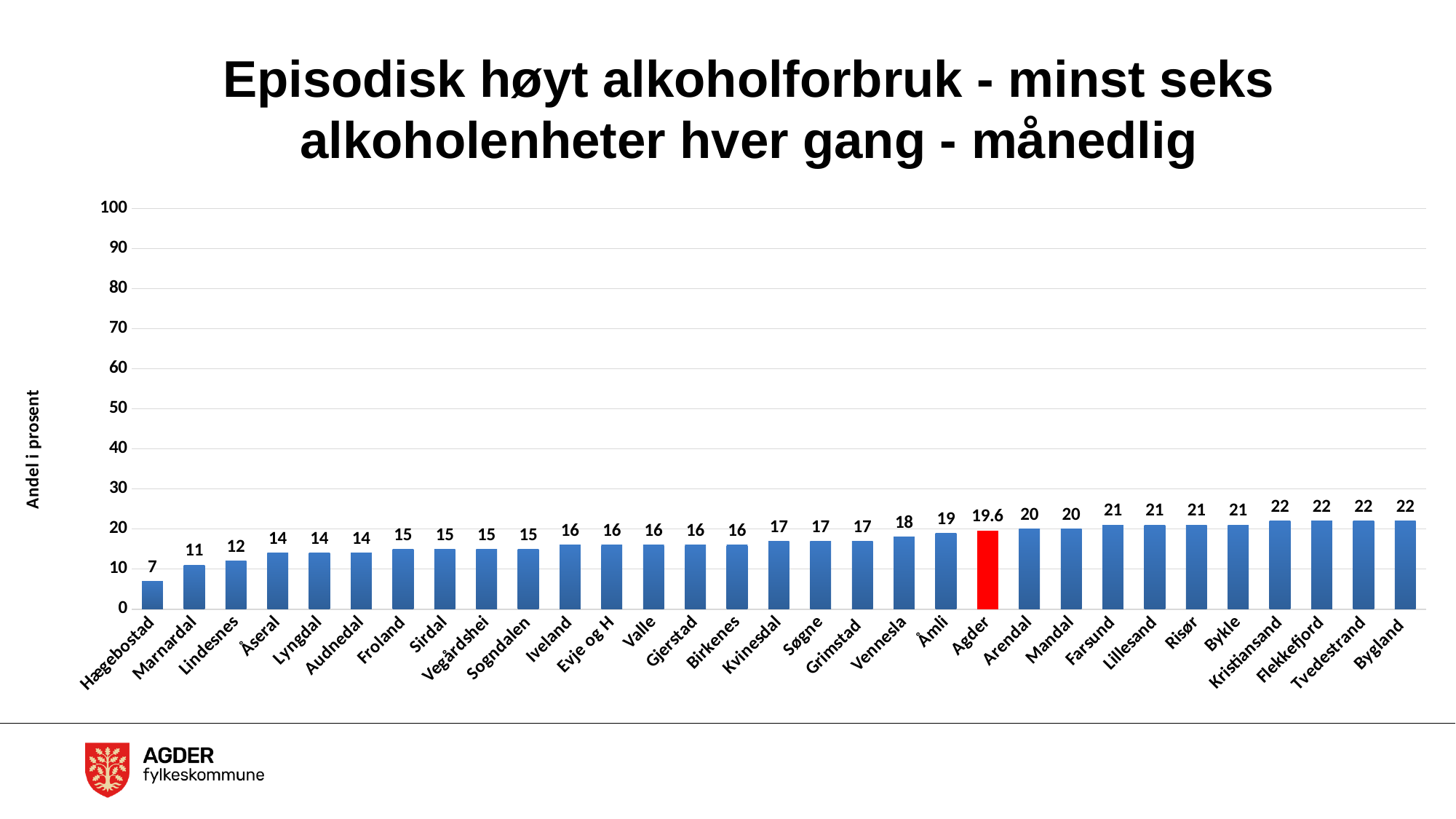
What kind of chart is shown on the slide? bar chart What is the difference between the values for Bygland and Hægebostad? 15 What is the difference between the values for Arendal and Marnardal? 9 Which is larger, the value for Farsund or the value for Lindesnes? Farsund Which category has the lowest value? Hægebostad Is the value for Grimstad greater or less than 30? less What is the value for Vennesla? 18 What is the value for Hægebostad? 7 What is the value for Agder? 19.6 What is the value for Kristiansand? 22 Which bar is coloured red instead of blue? Agder How many categories are shown on the x axis? 31